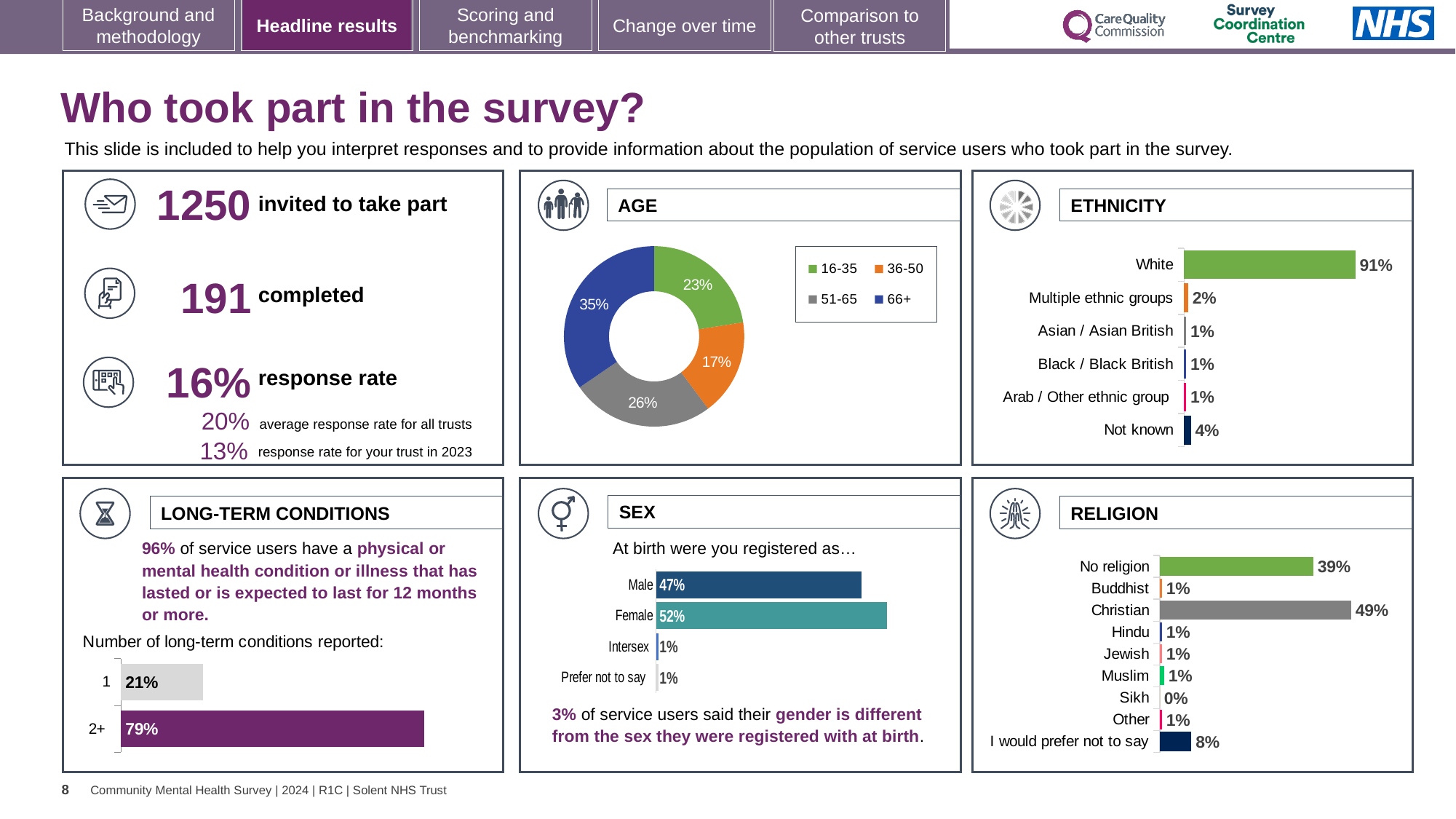
In the ETHNICITY chart, what is the difference between White and Not known? 87% In the ETHNICITY chart, what is the value for White? 91% What kind of chart is the AGE chart? Doughnut chart In the RELIGION chart, which category has the highest value? Christian In the RELIGION chart, what is the difference between Christian and No religion? 10% In the LONG-TERM CONDITIONS chart, what percentage reported 2+ conditions? 79% How many age groups does the legend of the AGE chart list? 4 In the AGE chart, which age group has the smallest share? 36-50 In the SEX chart, which is larger, Male or Female? Female How many categories are shown in the ETHNICITY chart? 6 In the SEX chart, what is the value for Intersex? 1% In the AGE chart, what percentage of respondents were aged 66+? 35%